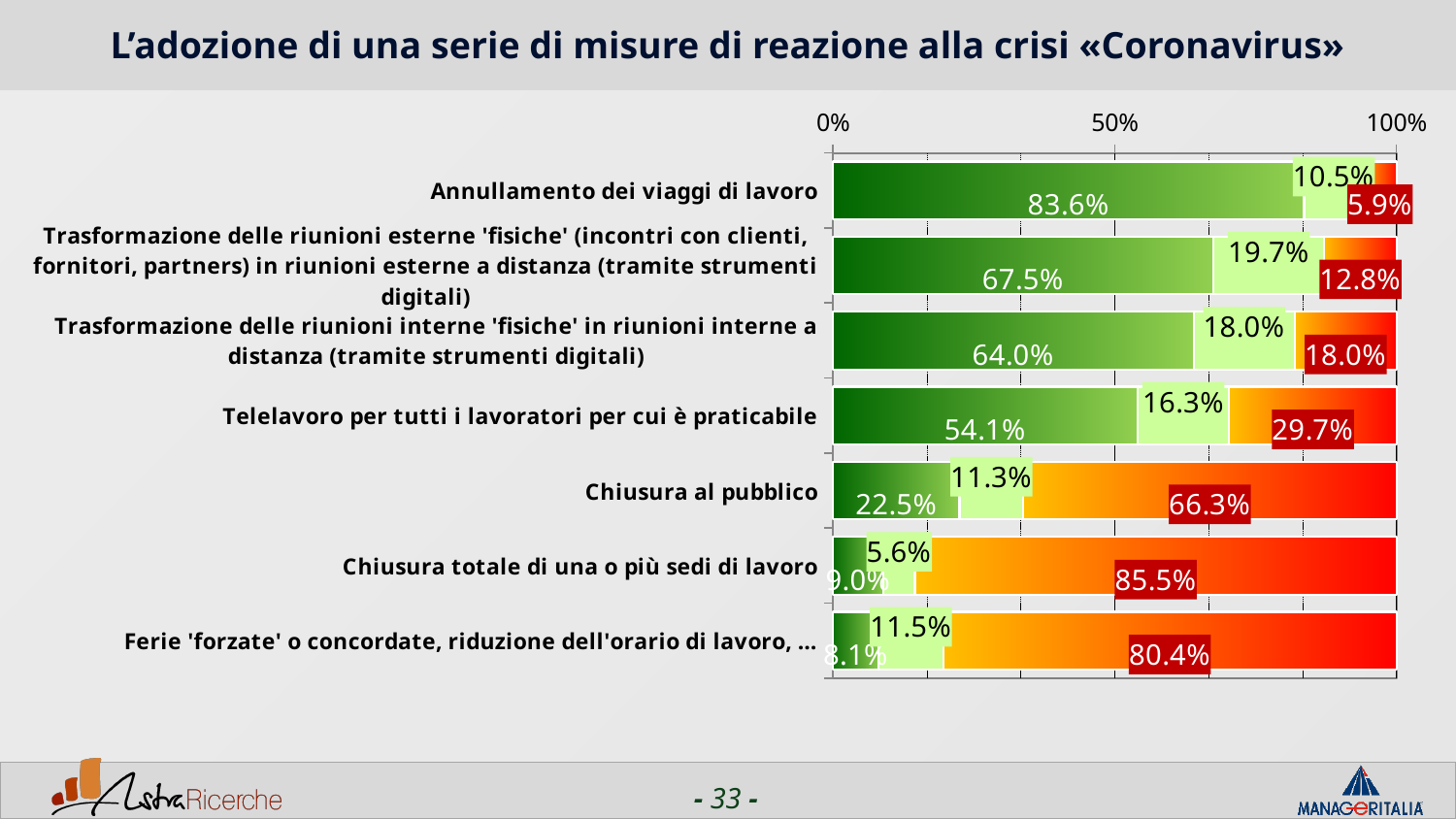
Is the dark green segment value for 'Chiusura al pubblico' greater or less than 50%? less How many measures (categories) are listed on the chart? 7 What is the value of the dark green (first) segment for 'Annullamento dei viaggi di lavoro'? 83.6% What is the value of the red (last) segment for 'Chiusura al pubblico'? 66.3% Which measure has the lowest value in the light green (middle) segment? Chiusura totale di una o più sedi di lavoro What is the difference between the dark green segment values for 'Annullamento dei viaggi di lavoro' and 'Telelavoro per tutti i lavoratori per cui è praticabile'? 29.5% Which measure has the highest value in the dark green (first) segment? Annullamento dei viaggi di lavoro What is the value of the red (last) segment for 'Chiusura totale di una o più sedi di lavoro'? 85.5% What type of chart is shown on the slide? stacked bar chart Which is larger: the red segment for 'Chiusura al pubblico' or the red segment for 'Telelavoro per tutti i lavoratori per cui è praticabile'? Chiusura al pubblico What is the value of the light green (middle) segment for 'Telelavoro per tutti i lavoratori per cui è praticabile'? 16.3% What is the title of the chart on the slide? L'adozione di una serie di misure di reazione alla crisi «Coronavirus»